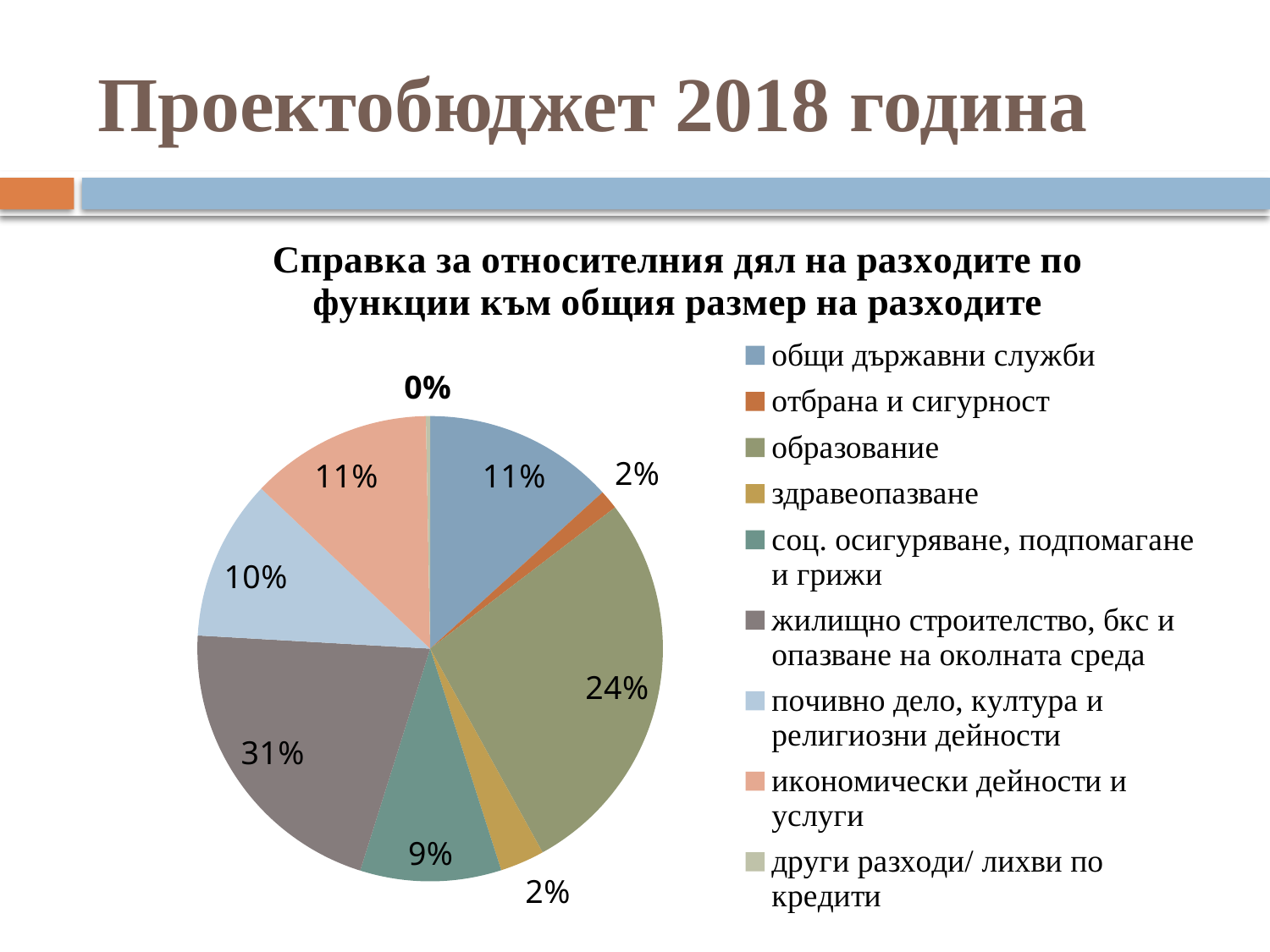
What is the difference in percentage points between the shares of "жилищно строителство, бкс и опазване на околната среда" and "образование"? 7 Which has a larger share: "образование" or "общи държавни служби"? образование What share of the pie does "други разходи/ лихви по кредити" have? 0% What kind of chart is shown on the slide? pie chart What share of the pie does "образование" have? 24% What share of the pie does "жилищно строителство, бкс и опазване на околната среда" have? 31% How many categories does the legend list? 9 What is the title of the chart? Справка за относителния дял на разходите по функции към общия размер на разходите What share of the pie does "соц. осигуряване, подпомагане и грижи" have? 9% Which category has the smallest share of the pie? други разходи/ лихви по кредити What share of the pie does "почивно дело, култура и религиозни дейности" have? 10%